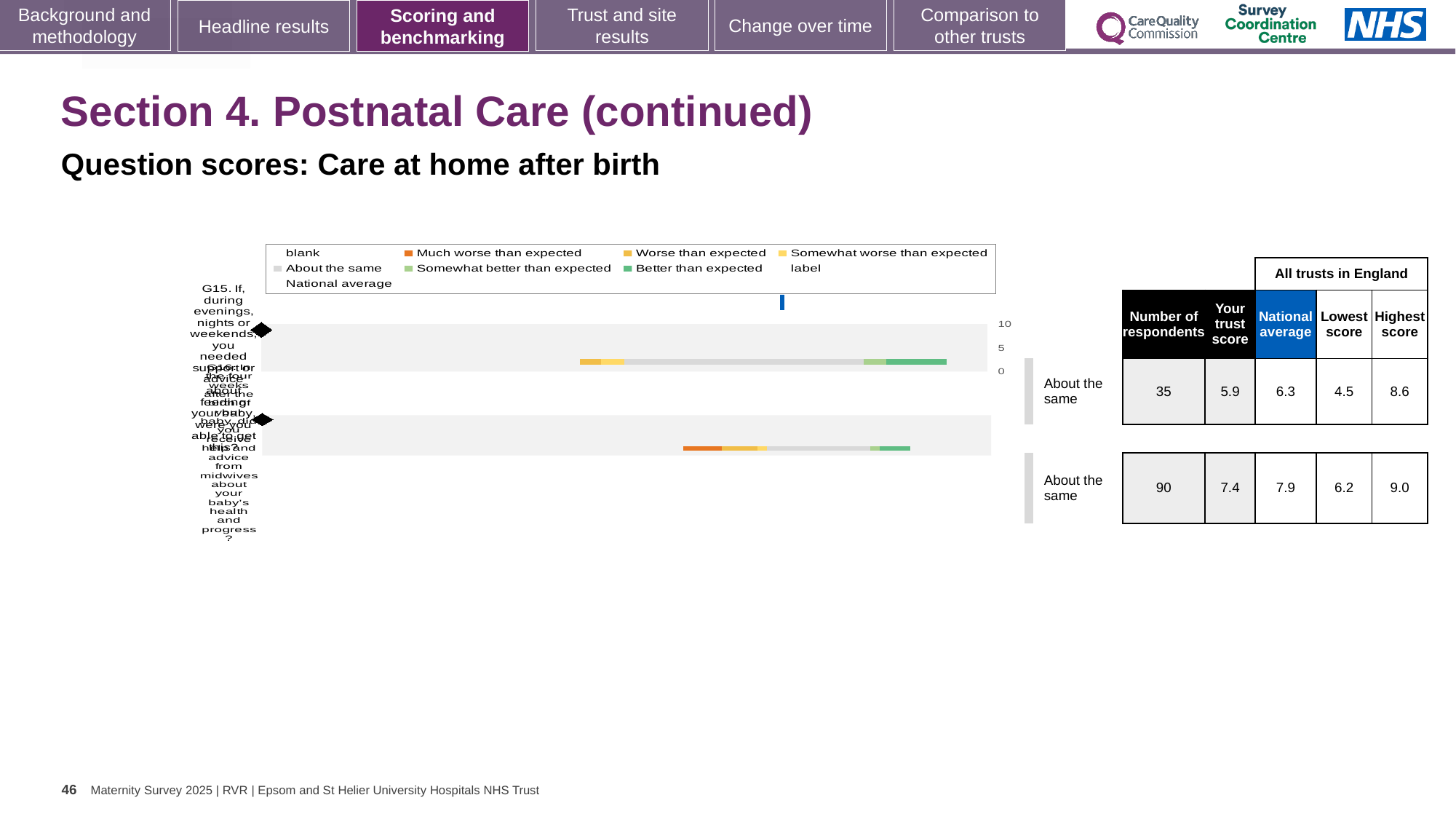
Which question row has the higher trust score, the top row or the bottom row? bottom row In the table beside the chart, what is the highest score for the bottom question row? 9.0 How many question rows are plotted in the chart? 2 What is the difference between the national average and the trust score for the top question row? 0.4 What kind of chart is shown on the slide? bar chart Which colour does the legend use for 'Much worse than expected'? orange In the table beside the chart, what is the trust score for the top question row? 5.9 In the table beside the chart, what is the number of respondents for the top question row? 35 In the table beside the chart, what is the lowest score for the top question row? 4.5 What benchmark category is shown for both question rows? About the same What is the difference in number of respondents between the bottom and top question rows? 55 In the table beside the chart, what is the national average for the bottom question row? 7.9